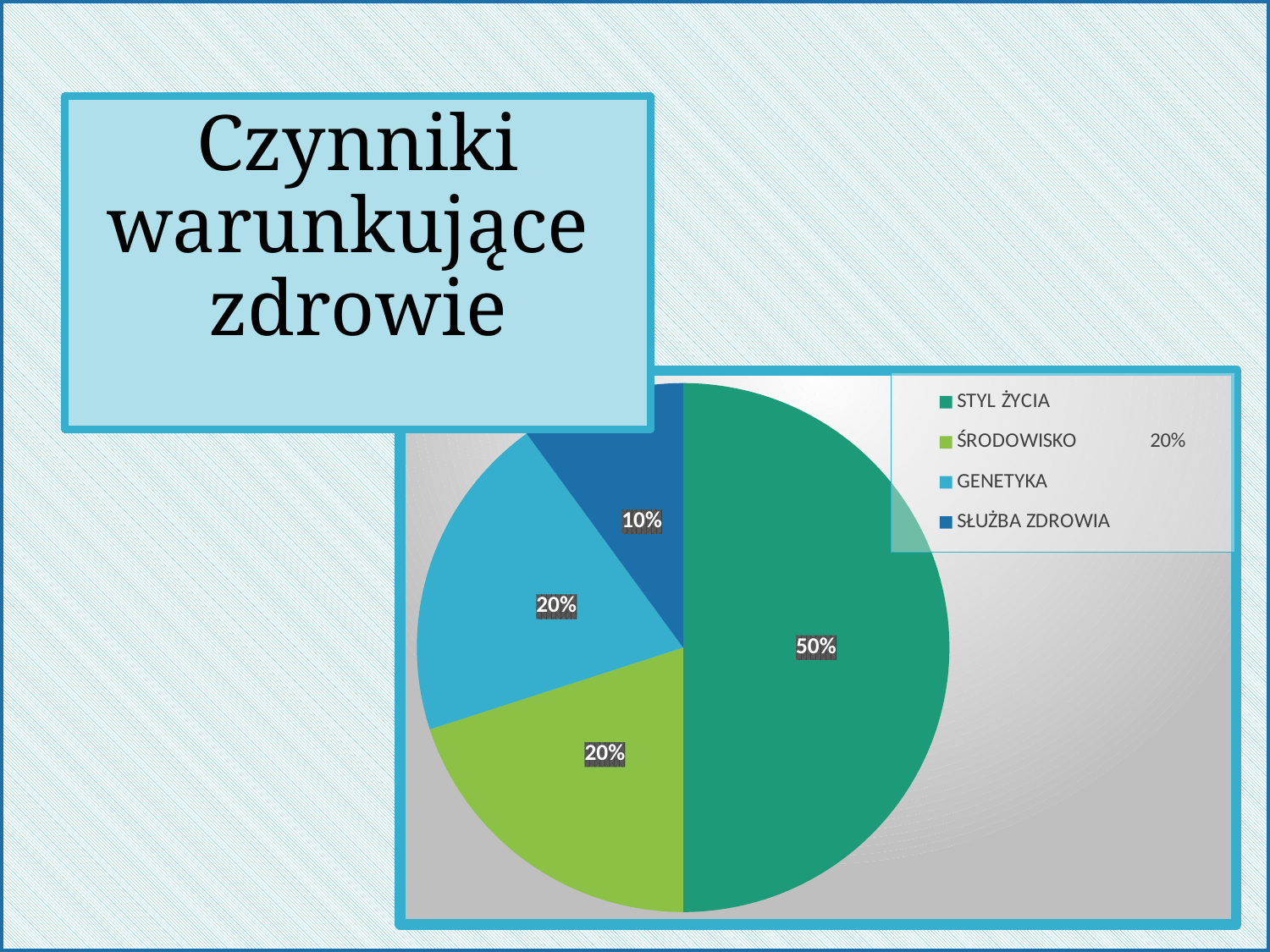
Which colour represents STYL ŻYCIA in the legend? dark green What share of the pie does STYL ŻYCIA have? 50% What share of the pie does ŚRODOWISKO have? 20% Which is larger, the share of GENETYKA or the share of SŁUŻBA ZDROWIA? GENETYKA What share of the pie does SŁUŻBA ZDROWIA have? 10% What is the difference between the shares of STYL ŻYCIA and SŁUŻBA ZDROWIA? 40% Which category has the smallest slice of the pie? SŁUŻBA ZDROWIA What kind of chart is shown on the slide? pie chart What share of the pie does GENETYKA have? 20% How many categories does the pie chart have? 4 What is the title of the slide? Czynniki warunkujące zdrowie Which category has the largest slice of the pie? STYL ŻYCIA